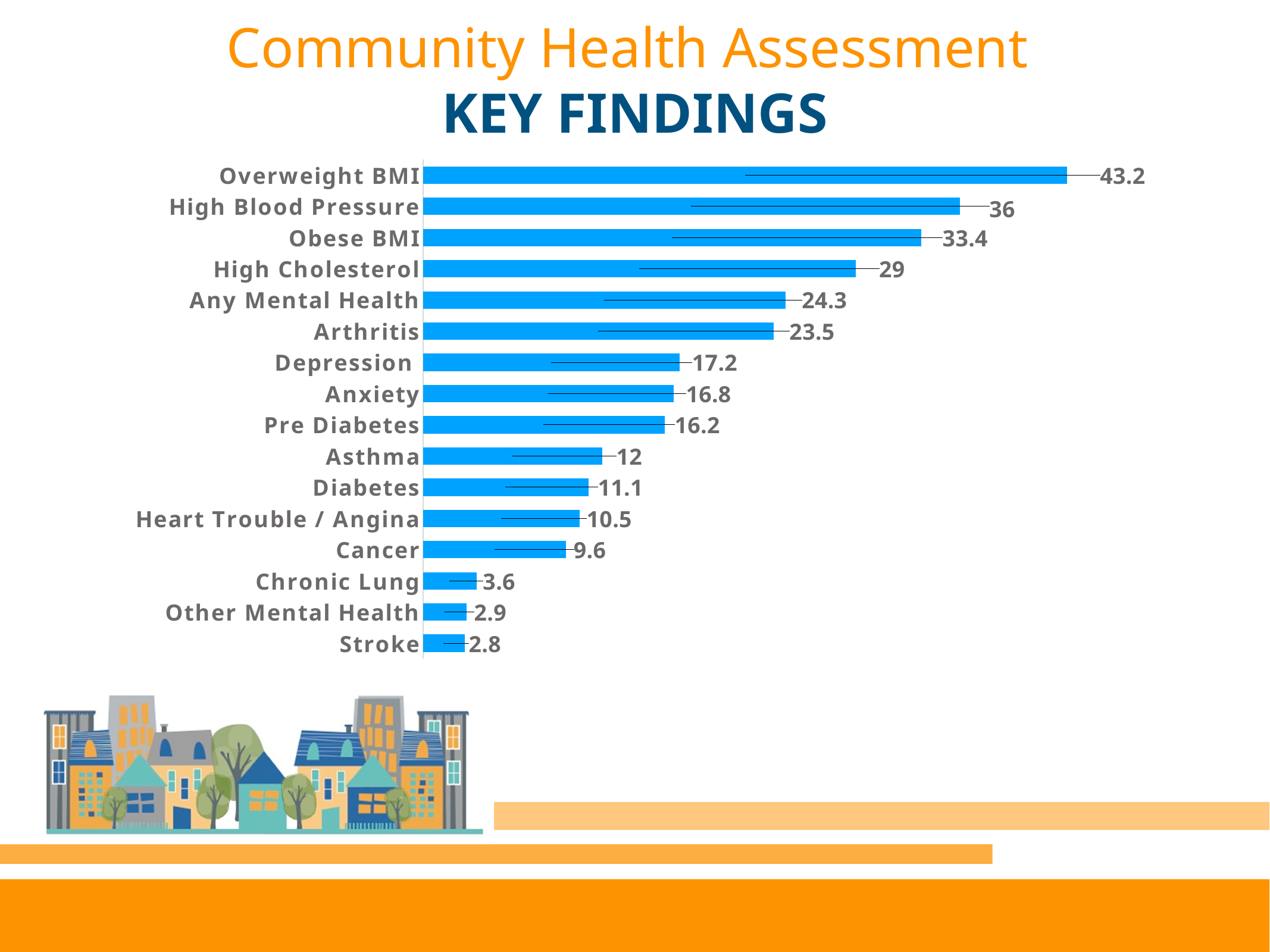
What kind of chart is shown on the slide? Bar chart Which is larger, the value for Cancer or the value for Chronic Lung? Cancer What is the difference between the values for Asthma and Diabetes? 0.9 What colour are the bars in the chart? Blue What is the value for Overweight BMI? 43.2 How many categories are shown in the chart? 16 What is the value for Heart Trouble / Angina? 10.5 Which is larger, the value for Depression or the value for Pre Diabetes? Depression Which category has the lowest value? Stroke What is the difference between the values for High Blood Pressure and Obese BMI? 2.6 What is the value for Arthritis? 23.5 Which category has the highest value? Overweight BMI